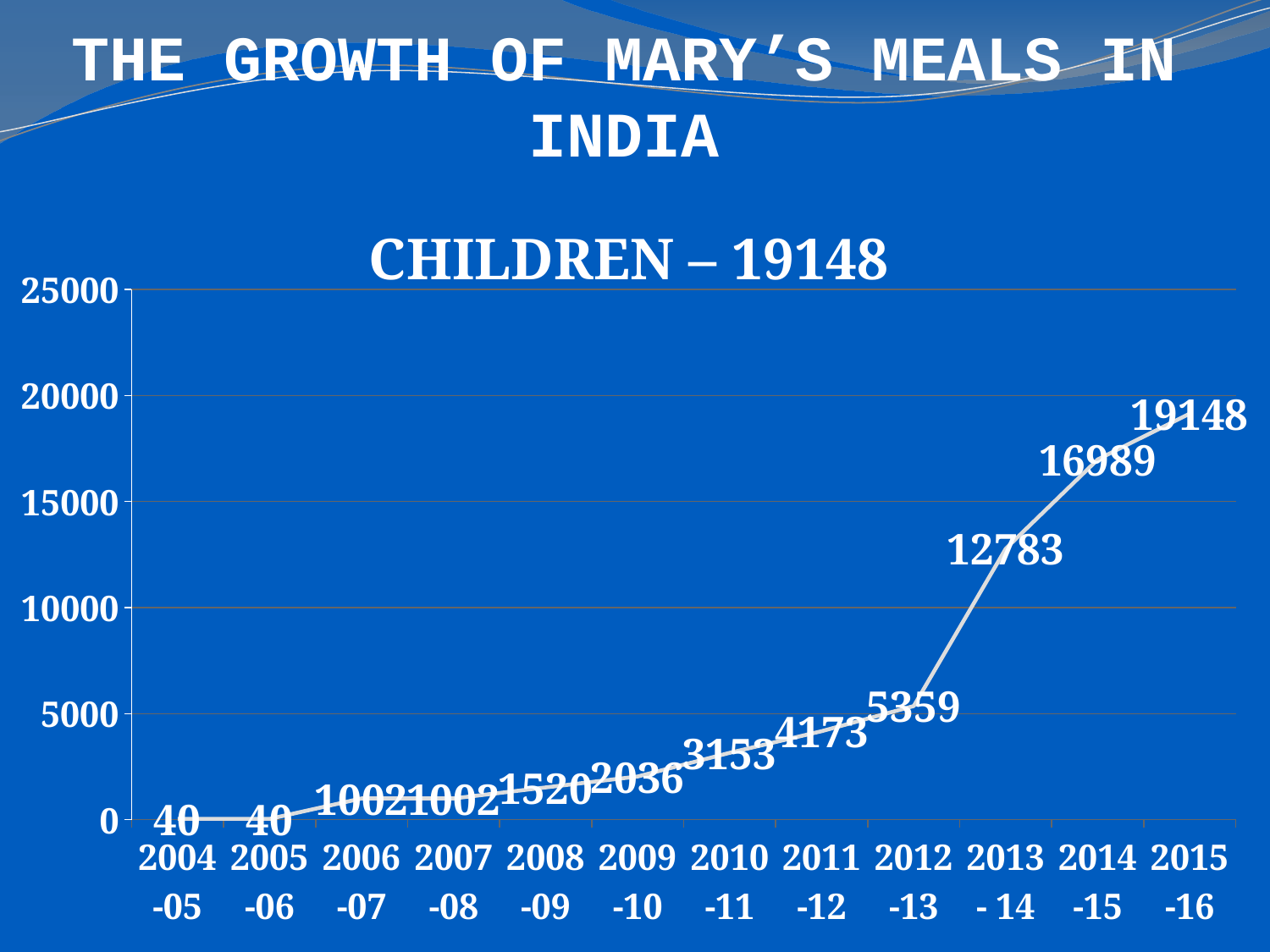
What is the value for 2015-16? 19148 How many data points are plotted on the line? 12 What is the value for 2013-14? 12783 Do the values generally rise or fall from 2004-05 to 2015-16? rise What is the value for 2004-05? 40 Which year has the highest value? 2015-16 What is the chart's title? CHILDREN – 19148 What is the difference between the values for 2013-14 and 2012-13? 7424 Which is larger, the value for 2011-12 or the value for 2010-11? 2011-12 What is the difference between the values for 2015-16 and 2014-15? 2159 What kind of chart is shown on the slide? line chart What is the value for 2009-10? 2036